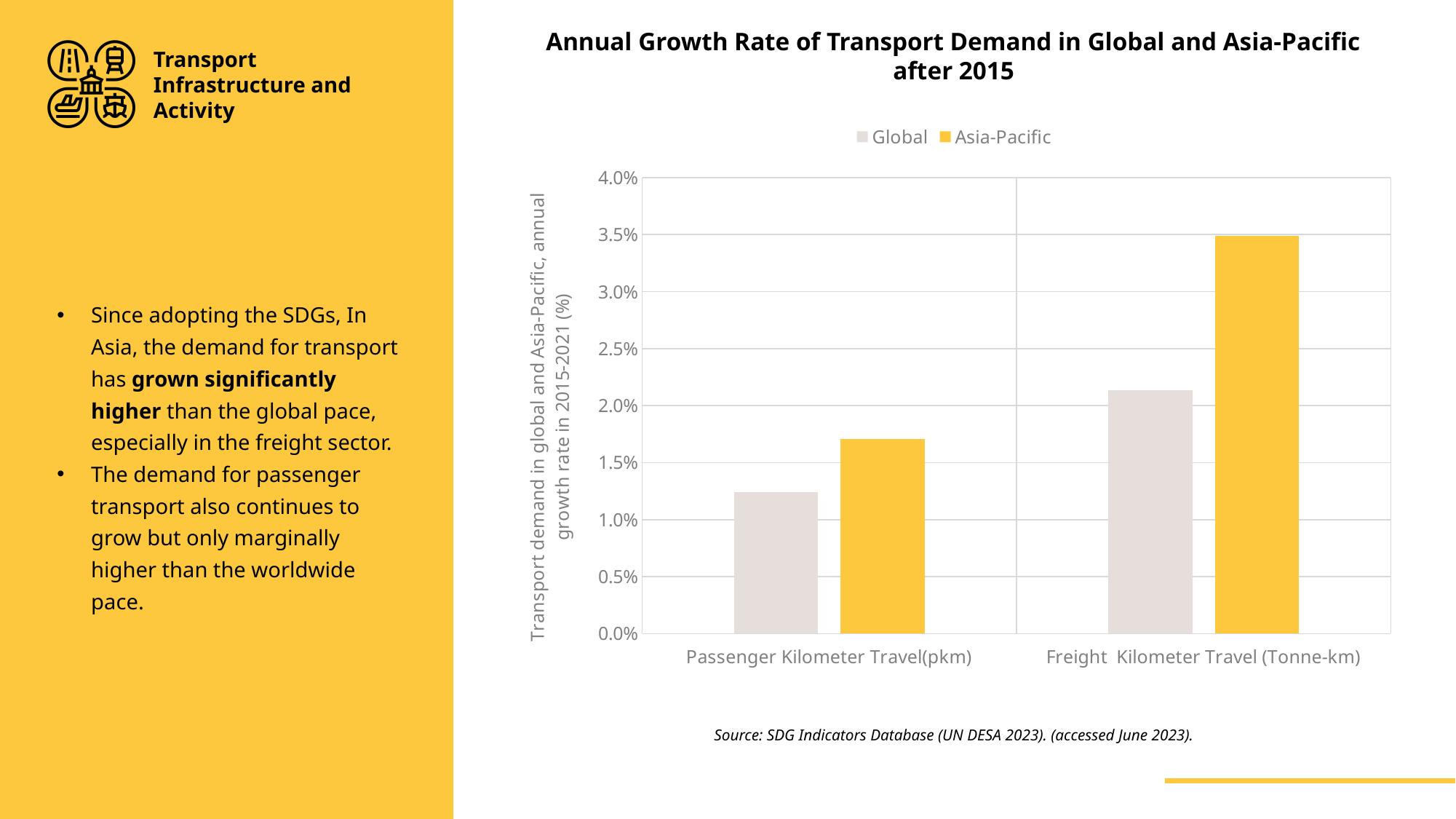
Which bar is the highest in the chart? Asia-Pacific, Freight Kilometer Travel (Tonne-km) Is the Global value for Freight Kilometer Travel (Tonne-km) greater or less than 2.5%? less Which bar is the lowest in the chart? Global, Passenger Kilometer Travel(pkm) For Freight Kilometer Travel (Tonne-km), which series has the larger value, Global or Asia-Pacific? Asia-Pacific What type of chart is shown on the slide? bar chart How many categories are shown on the x axis? 2 Is the Global value for Passenger Kilometer Travel(pkm) greater or less than 1.5%? less Which series is shown in yellow? Asia-Pacific Is the Asia-Pacific value for Passenger Kilometer Travel(pkm) greater or less than 1.5%? greater What is the title of the chart? Annual Growth Rate of Transport Demand in Global and Asia-Pacific after 2015 How many series does the legend list? 2